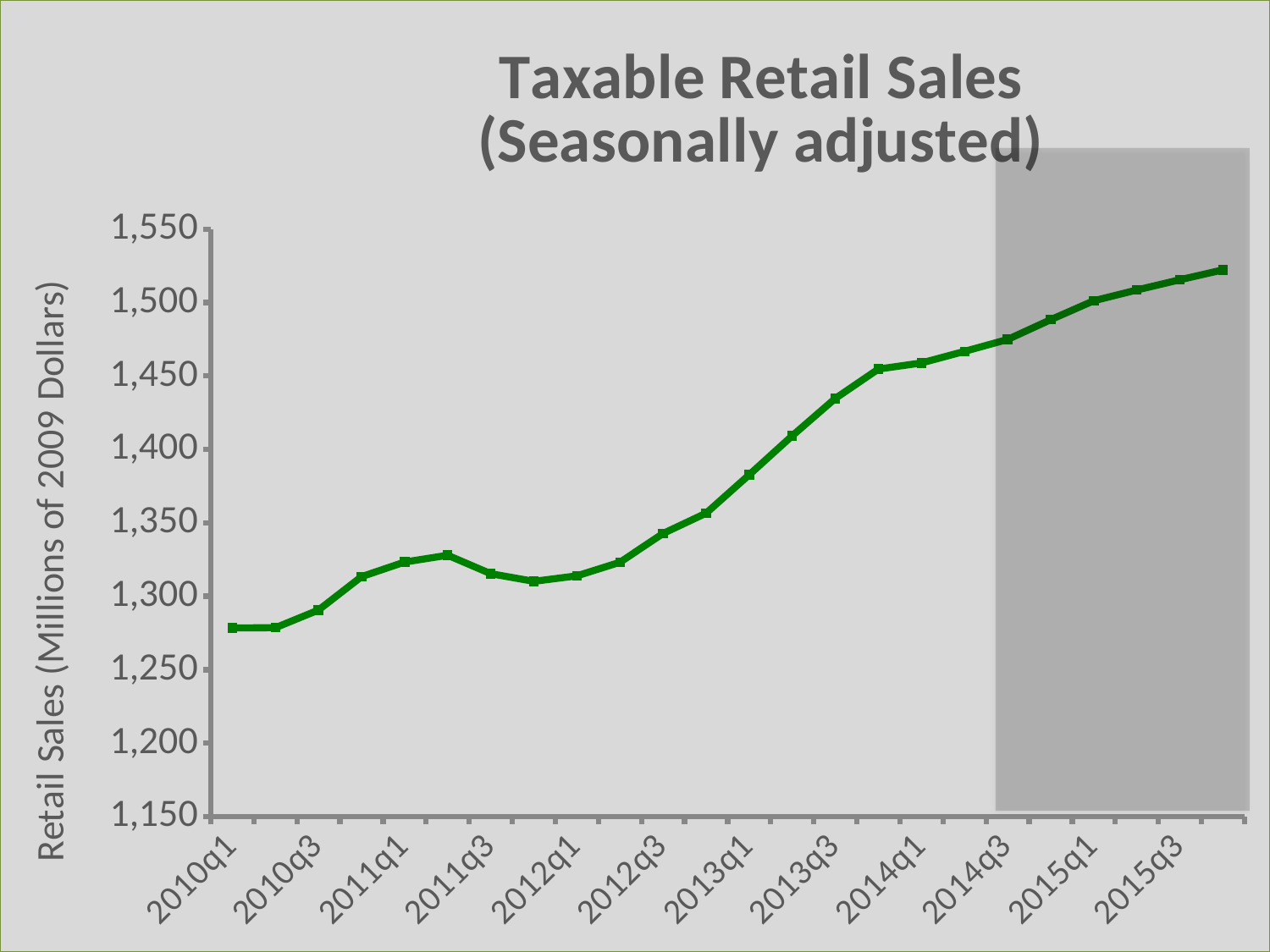
Is the value for 2010q1 greater or less than 1,300? less What kind of chart is shown on the slide? line chart What is the title of the chart? Taxable Retail Sales (Seasonally adjusted) Is the value for 2011q3 greater or less than 1,350? less Which is larger, the value for 2013q3 or the value for 2011q1? 2013q3 Is the value for 2014q1 greater or less than 1,400? greater Which quarter has the highest taxable retail sales value on the chart? 2015q4 What is the label on the vertical axis of the chart? Retail Sales (Millions of 2009 Dollars) Overall, do taxable retail sales rise or fall from 2010q1 to 2015q4? rise How many quarterly data points are plotted on the line? 24